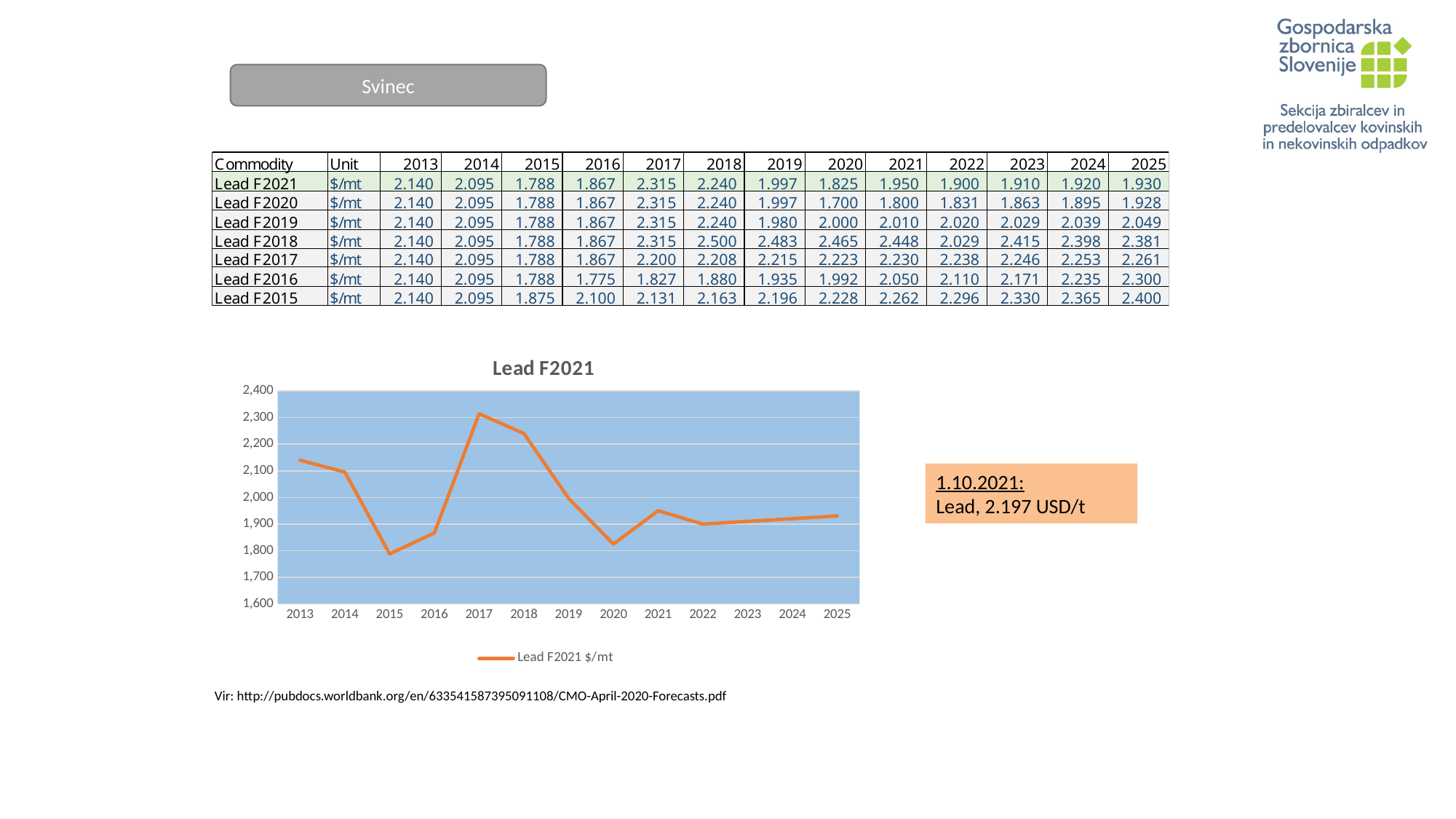
Is the Lead F2021 value for 2020 greater or less than 1,900? less What type of chart is shown on the slide? line chart In which year does the Lead F2021 line reach its lowest value? 2015 Which year has the larger Lead F2021 value, 2013 or 2016? 2013 What is the title of the chart? Lead F2021 According to the Lead F2021 row of the table, what is the value for 2015? 1.788 How many series does the chart legend list? 1 According to the Lead F2021 row of the table, what is the value for 2017? 2.315 Does the Lead F2021 line rise or fall from 2021 to 2025? fall In which year does the Lead F2021 line reach its highest value? 2017 Is the Lead F2021 value for 2018 greater or less than 2,200? greater How many years are plotted along the x axis of the chart? 13